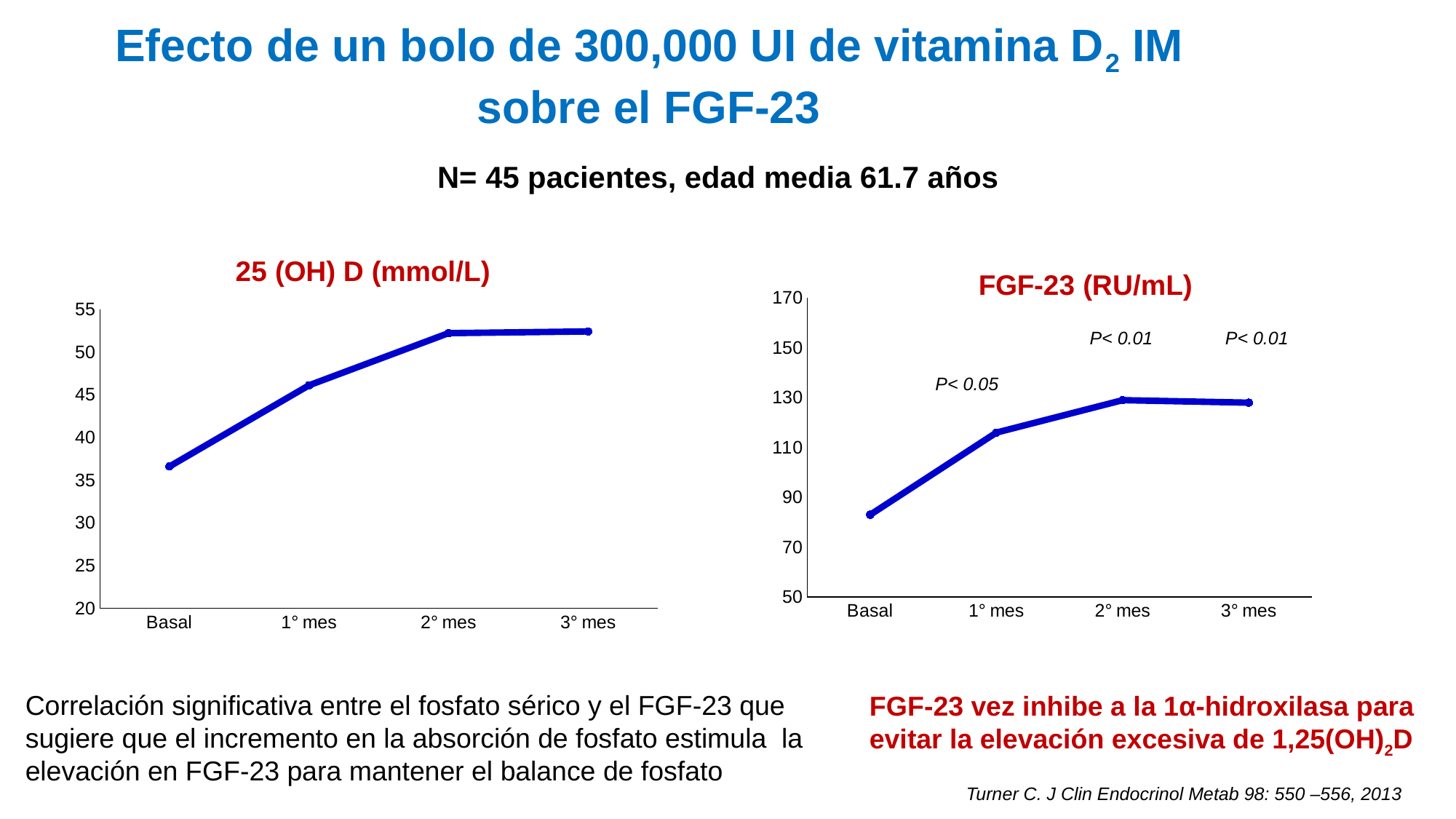
On the "FGF-23 (RU/mL)" chart, is the value for Basal greater or less than 90? less On the "25 (OH) D (mmol/L)" chart, which time point has the lowest value? Basal On the "25 (OH) D (mmol/L)" chart, do the values rise or fall from Basal to 2° mes? rise What is the title of the chart on the right side of the slide? FGF-23 (RU/mL) What kind of chart is the "25 (OH) D (mmol/L)" chart? line chart On the "25 (OH) D (mmol/L)" chart, is the value for Basal greater or less than 40? less How many time points are plotted on the "FGF-23 (RU/mL)" chart? 4 On the "25 (OH) D (mmol/L)" chart, is the value for 2° mes greater or less than 50? greater On the "FGF-23 (RU/mL)" chart, what P value is shown above the 1° mes point? P< 0.05 On the "FGF-23 (RU/mL)" chart, which is larger, the value for Basal or the value for 1° mes? 1° mes On the "FGF-23 (RU/mL)" chart, which time point has the lowest value? Basal